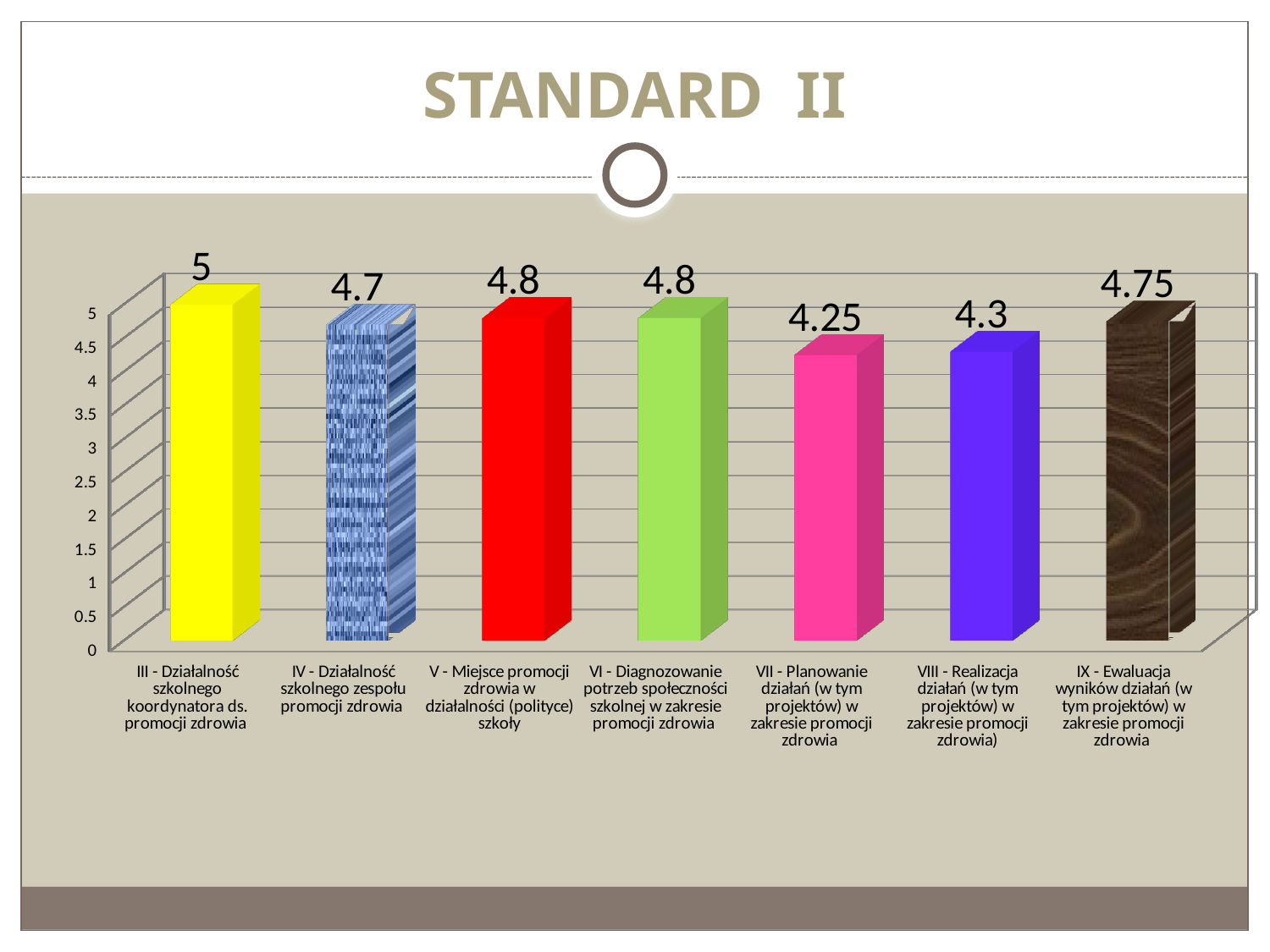
What is the value for 'III - Działalność szkolnego koordynatora ds. promocji zdrowia'? 5 Which is larger: the value for 'VIII - Realizacja działań (w tym projektów) w zakresie promocji zdrowia)' or the value for 'IX - Ewaluacja wyników działań (w tym projektów) w zakresie promocji zdrowia'? IX - Ewaluacja wyników działań (w tym projektów) w zakresie promocji zdrowia What is the value for 'VII - Planowanie działań (w tym projektów) w zakresie promocji zdrowia'? 4.25 What is the title of the slide? STANDARD II What is the value for 'IX - Ewaluacja wyników działań (w tym projektów) w zakresie promocji zdrowia'? 4.75 How many categories are shown in the chart? 7 What is the value for 'IV - Działalność szkolnego zespołu promocji zdrowia'? 4.7 Is the value for 'VIII - Realizacja działań (w tym projektów) w zakresie promocji zdrowia)' greater or less than 4? greater Which category has the lowest value? VII - Planowanie działań (w tym projektów) w zakresie promocji zdrowia What kind of chart is shown on the slide? bar chart Which category has the highest value? III - Działalność szkolnego koordynatora ds. promocji zdrowia What is the difference between the values for 'III - Działalność szkolnego koordynatora ds. promocji zdrowia' and 'VII - Planowanie działań (w tym projektów) w zakresie promocji zdrowia'? 0.75